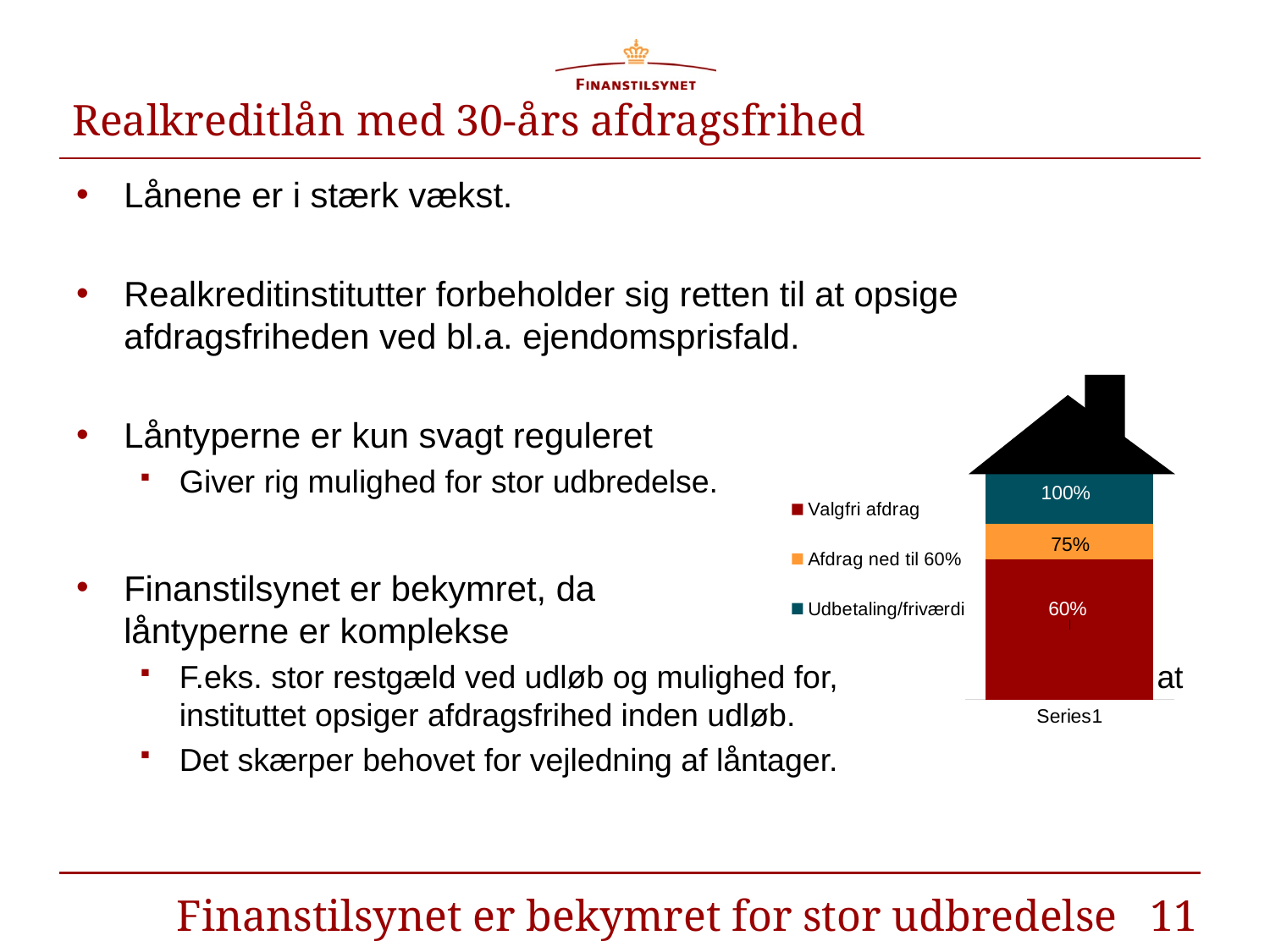
What kind of chart is shown on the slide? Stacked bar chart Which segment of the stacked bar is the shortest? Afdrag ned til 60% What label is printed on the Afdrag ned til 60% segment of the bar? 75% What label is printed on the Udbetaling/friværdi segment of the bar? 100% How many series does the chart legend list? 3 How many bars (categories) are plotted in the chart? 1 What is the category label shown under the bar? Series1 Which series is shown at the top of the stacked bar? Udbetaling/friværdi Which segment of the stacked bar is the tallest? Valgfri afdrag What label is printed on the Valgfri afdrag segment of the bar? 60%